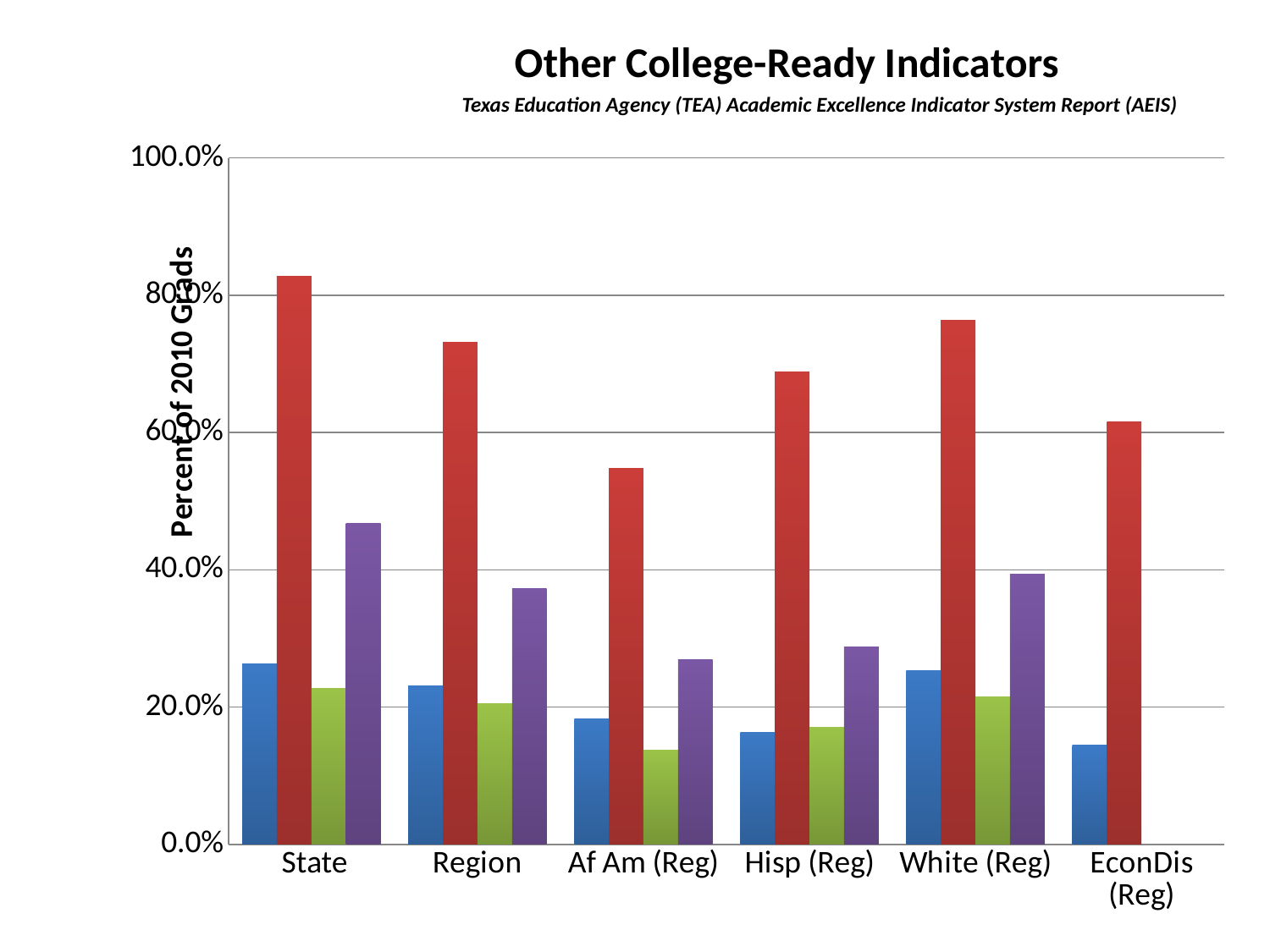
Which category has the tallest purple bar? State What is the title of the chart? Other College-Ready Indicators What kind of chart is shown on the slide? bar chart Which is larger, the red bar for State or the red bar for Region? State Which is larger, the blue bar for White (Reg) or the blue bar for Hisp (Reg)? White (Reg) How many categories are shown on the x axis? 6 What is the label on the y axis? Percent of 2010 Grads Is the purple bar for State greater or less than 40.0%? greater Is the red bar for Af Am (Reg) greater or less than 60.0%? less Which category has the shortest red bar? Af Am (Reg) Which category has the tallest red bar? State Is the green bar for Af Am (Reg) greater or less than 20.0%? less